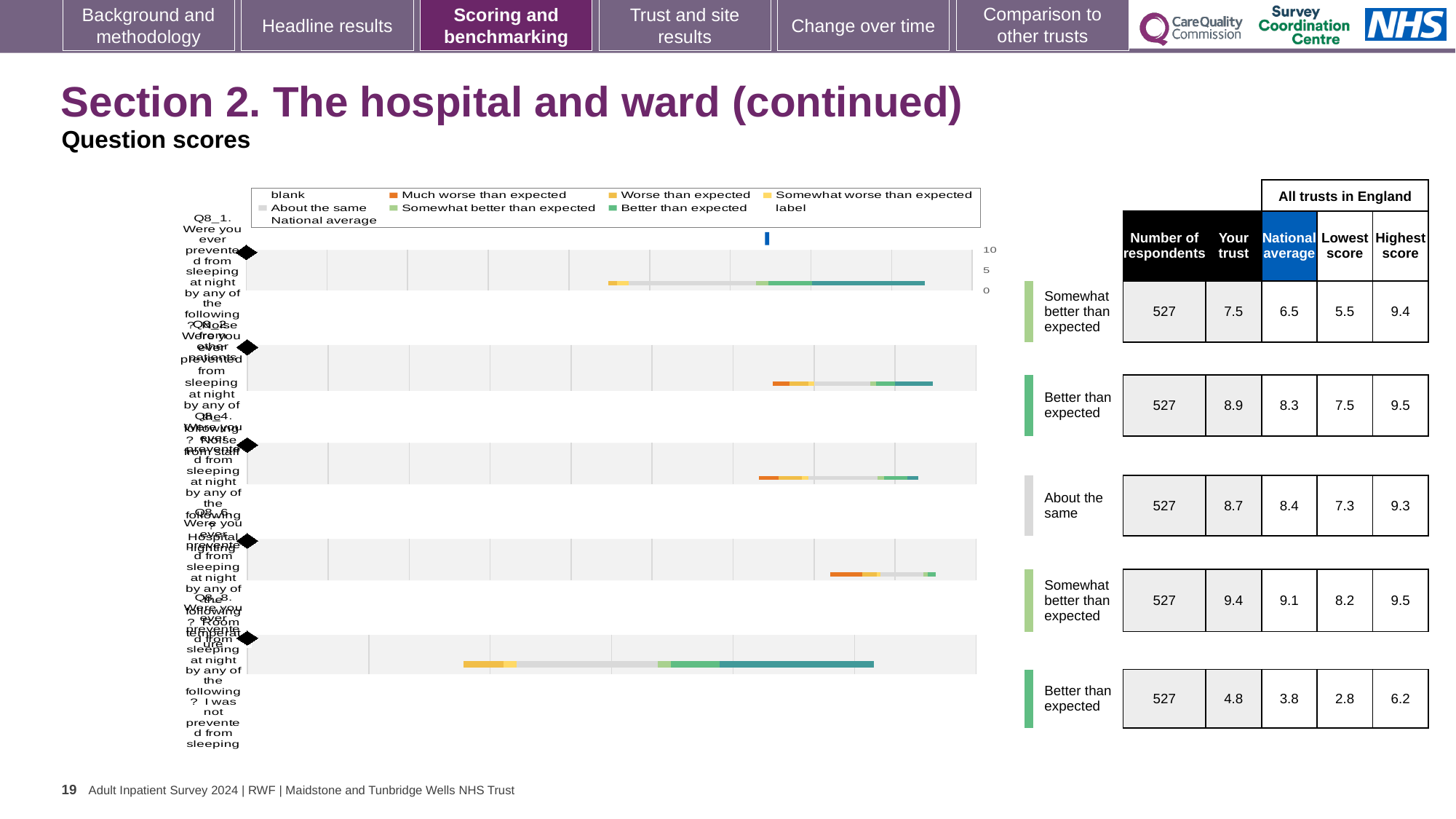
In the table, what is the difference between 'Your trust' and the national average in the bottom row? 1.0 What kind of chart is shown on the slide? bar chart In the table, what is the 'Your trust' score in the row labelled 'Somewhat better than expected' at the top? 7.5 How many horizontal bars (question rows) does the chart show? 5 In the table, which row has the highest 'Your trust' score? the fourth row (Somewhat better than expected, 9.4) In the table, what is the highest score in the bottom row labelled 'Better than expected'? 6.2 In the table, is the 'Your trust' score in the second row (8.9) larger or smaller than the national average (8.3)? larger In the table, how many respondents are listed for each question? 527 In the table, what is the national average in the row labelled 'About the same'? 8.4 What is the maximum value shown on the chart's score axis? 10 Which legend entry is shown in dark orange? Much worse than expected In the table, which row has the lowest 'Your trust' score? the bottom row (Better than expected, 4.8)